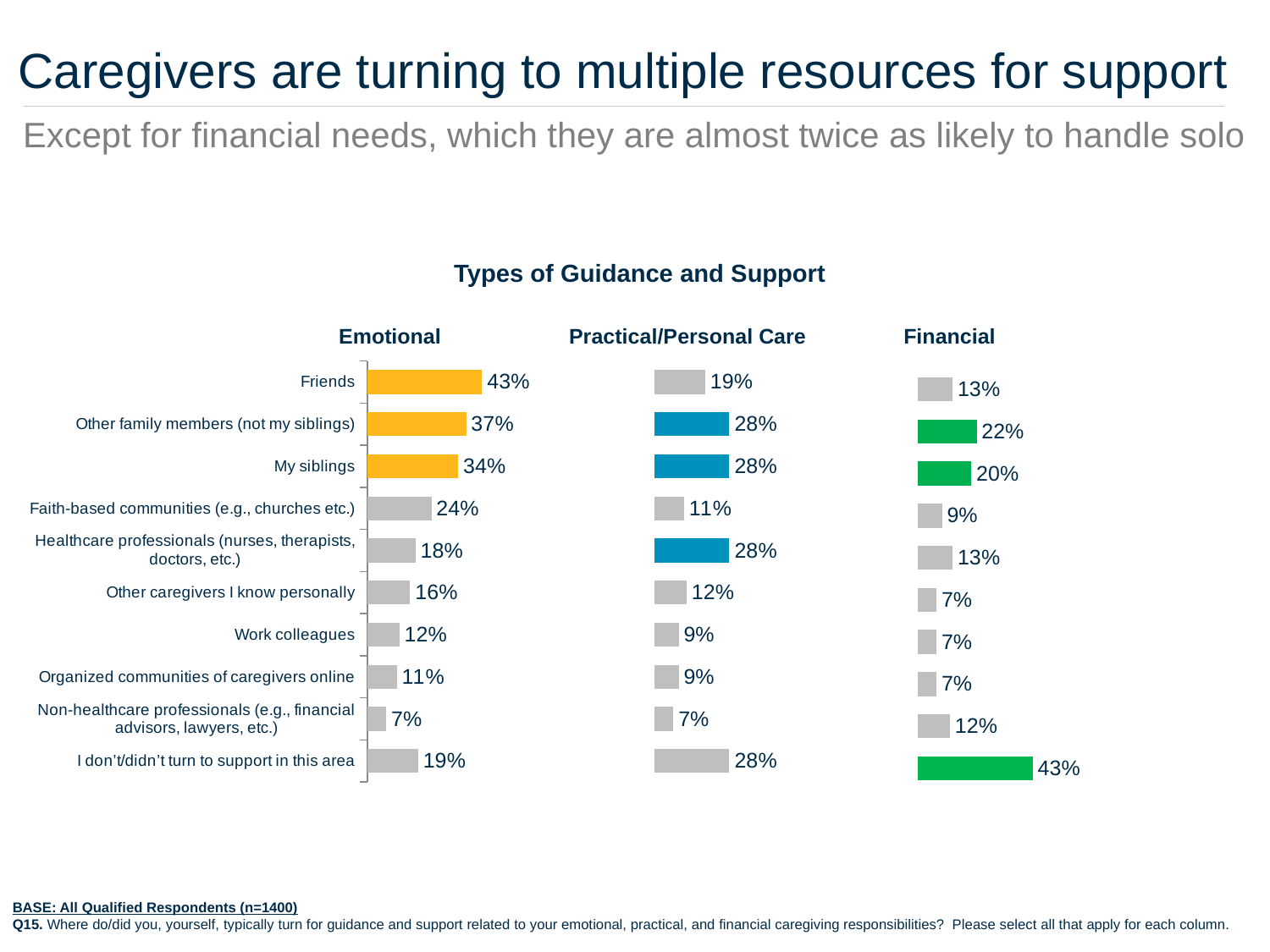
In the Emotional chart, what percentage of caregivers turn to Friends for support? 43% In the Financial chart, what is the difference between the value for I don't/didn't turn to support in this area and the value for Friends? 30% In the Financial chart, which is larger: the value for Other family members (not my siblings) or the value for My siblings? Other family members (not my siblings) In the Emotional chart, what is the difference between the values for Friends and My siblings? 9% In the Financial chart, what percentage of caregivers say they don't/didn't turn to support in this area? 43% What is the title shown above the three charts? Types of Guidance and Support What type of chart is used to show the Types of Guidance and Support data? Bar chart How many categories are listed in the Emotional chart? 10 In the Financial chart, which category has the highest value? I don't/didn't turn to support in this area In the Practical/Personal Care chart, what is the value for Faith-based communities (e.g., churches etc.)? 11% In the Emotional chart, which category has the lowest value? Non-healthcare professionals (e.g., financial advisors, lawyers, etc.) In the Practical/Personal Care chart, what is the value for Healthcare professionals (nurses, therapists, doctors, etc.)? 28%